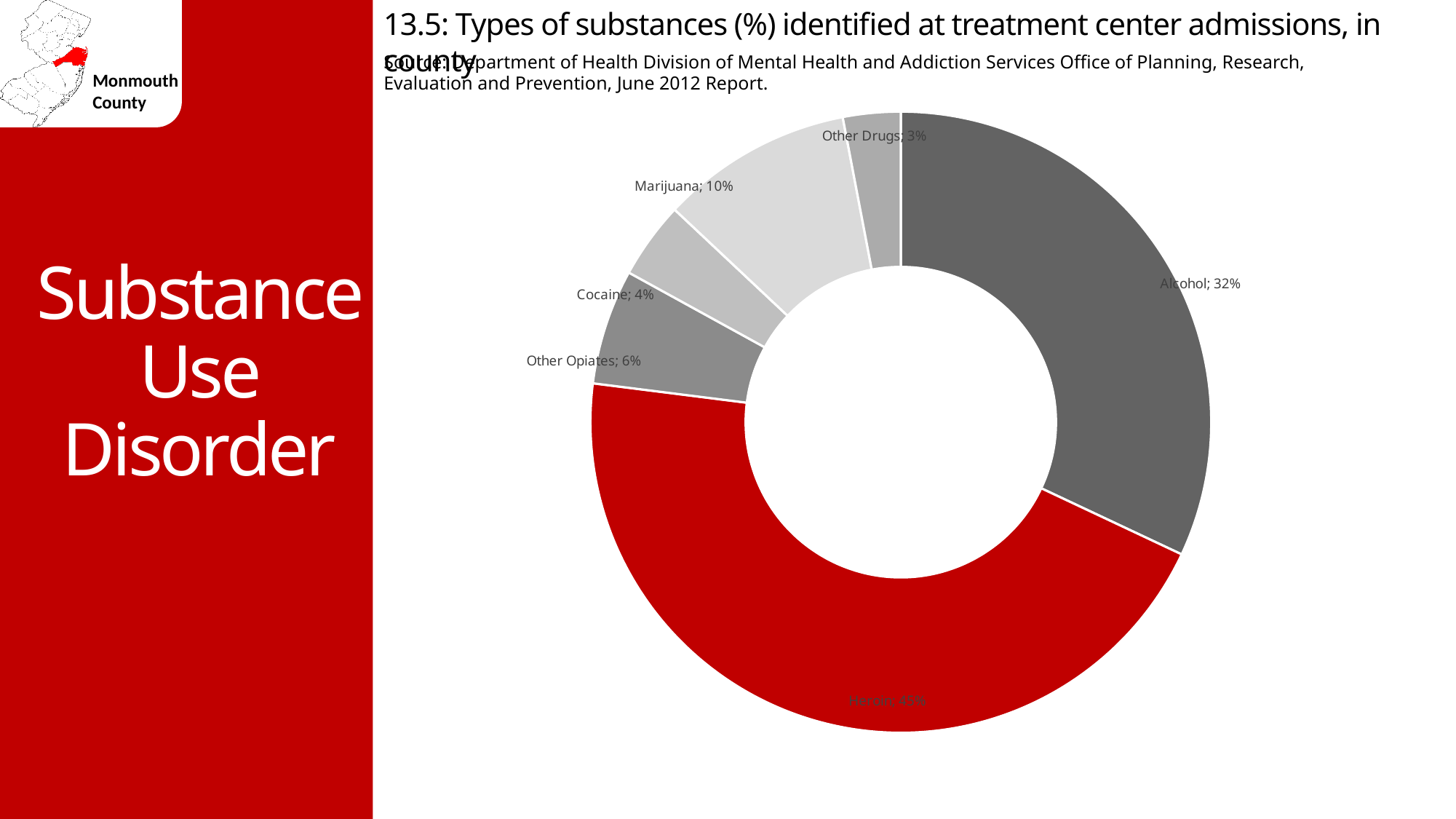
What type of chart is used on this slide? Doughnut (pie) chart What percentage is shown for Other Opiates? 6% What percentage of treatment center admissions is attributed to Alcohol? 32% What is the difference in percentage points between Heroin and Alcohol? 13 What percentage is shown for Marijuana? 10% What percentage of treatment center admissions is attributed to Heroin? 45% What colour is the Heroin slice? Red Which substance has the smallest share of treatment center admissions? Other Drugs Which has a larger share, Marijuana or Other Opiates? Marijuana How many substance categories are shown in the chart? 6 Which substance has the largest share of treatment center admissions? Heroin What percentage is shown for Cocaine? 4%